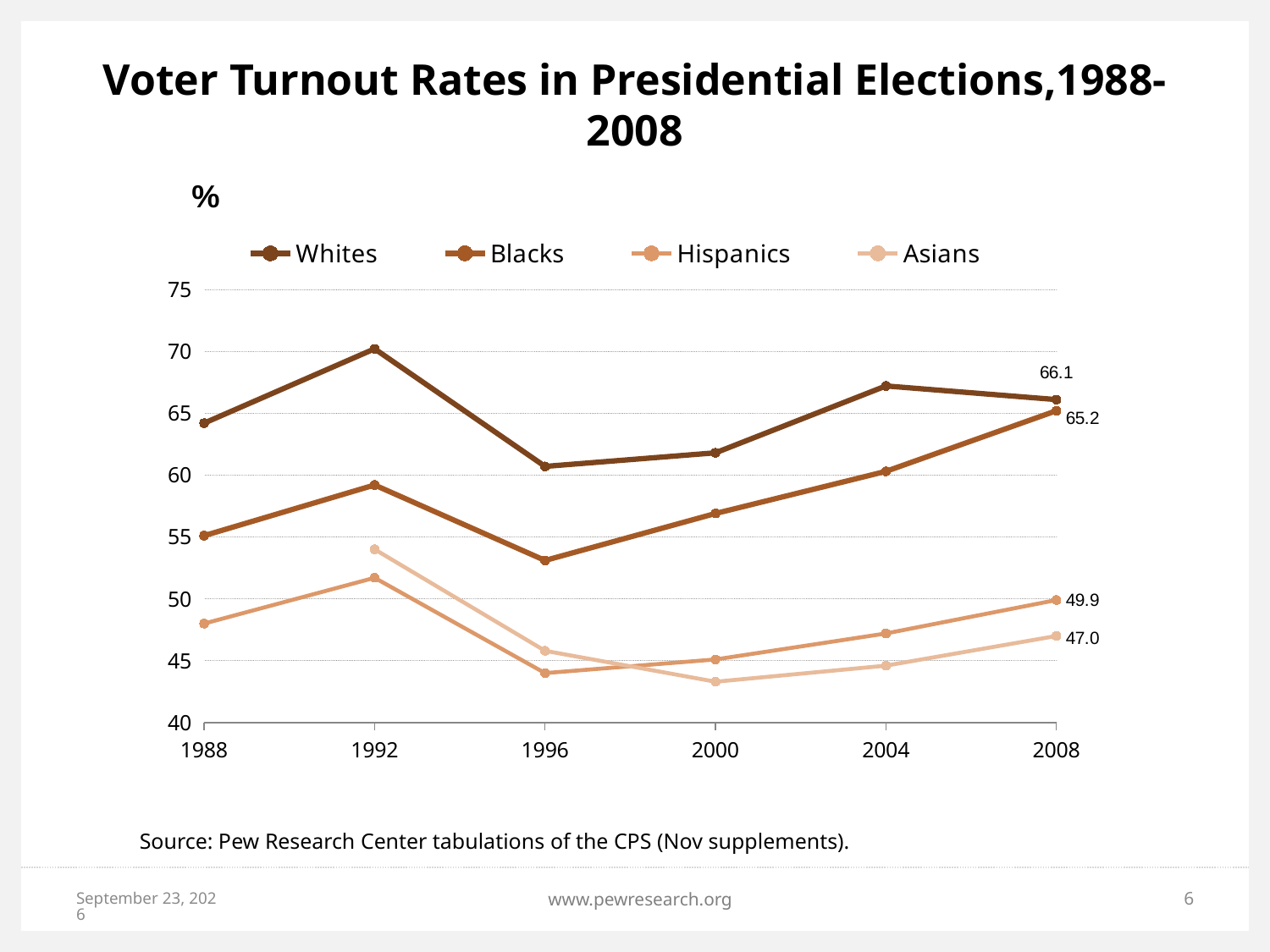
Does the turnout rate for Blacks rise or fall from 1996 to 2008? rise What is the voter turnout rate for Hispanics in 2008? 49.9 Is the turnout rate for Blacks in 1996 greater or less than 55? less What is the title of the chart? Voter Turnout Rates in Presidential Elections, 1988-2008 How many series does the legend list? 4 How many election years are plotted along the x axis? 6 What is the voter turnout rate for Blacks in 2008? 65.2 What is the difference between the 2008 turnout rates for Whites and Blacks? 0.9 What is the voter turnout rate for Asians in 2008? 47.0 What is the voter turnout rate for Whites in 2008? 66.1 Which group has the lowest turnout rate in 2008? Asians What type of chart is shown on the slide? line chart